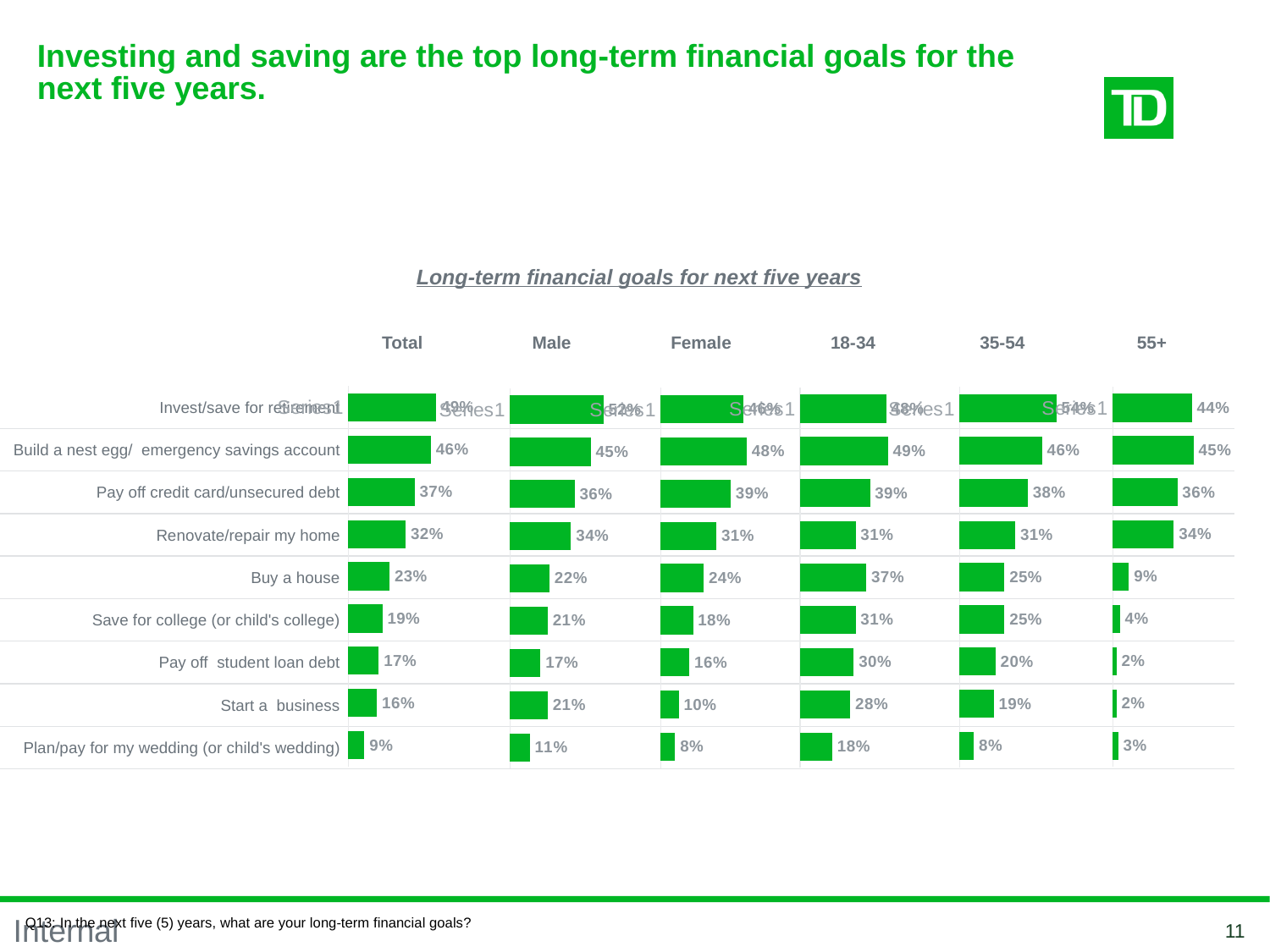
How many categories are shown in each chart? 9 In the Male chart, what is the value for Plan/pay for my wedding (or child's wedding)? 11% Which is larger: Start a business in the Male chart or Start a business in the Female chart? Male In the 55+ chart, what is the value for Pay off student loan debt? 2% In the Total chart, which category has the lowest value? Plan/pay for my wedding (or child's wedding) In the 35-54 chart, what is the value for Pay off credit card/unsecured debt? 38% In the 18-34 chart, what is the value for Buy a house? 37% In the Total chart, what is the value for Build a nest egg/ emergency savings account? 46% What kind of chart is used for each column on the slide? Bar chart In the 18-34 chart, what is the difference between Buy a house and Save for college (or child's college)? 6% In the Female chart, what is the value for Start a business? 10% What is the title shown above the charts? Long-term financial goals for next five years